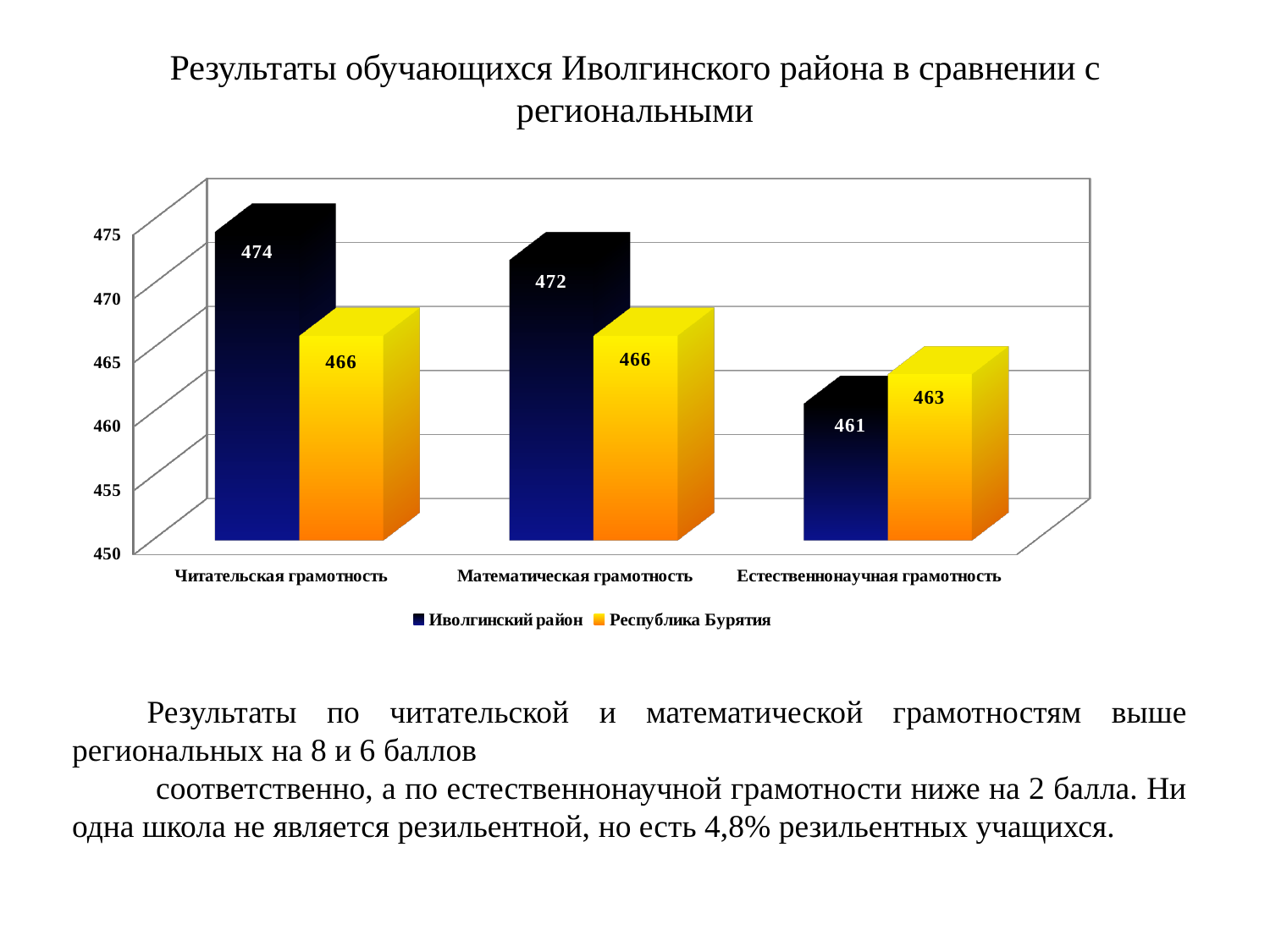
In which category does Республика Бурятия have its lowest value? Естественнонаучная грамотность Which series has the larger value in Естественнонаучная грамотность, Иволгинский район or Республика Бурятия? Республика Бурятия What is the value for Республика Бурятия in Естественнонаучная грамотность? 463 How many categories are shown on the x axis? 3 How many series does the legend list? 2 What is the value for Иволгинский район in Читательская грамотность? 474 In which category does Иволгинский район have its highest value? Читательская грамотность What kind of chart is shown on the slide? Bar chart What is the difference between Иволгинский район and Республика Бурятия in Читательская грамотность? 8 What is the difference between Иволгинский район and Республика Бурятия in Математическая грамотность? 6 What is the value for Республика Бурятия in Математическая грамотность? 466 What is the value for Иволгинский район in Естественнонаучная грамотность? 461